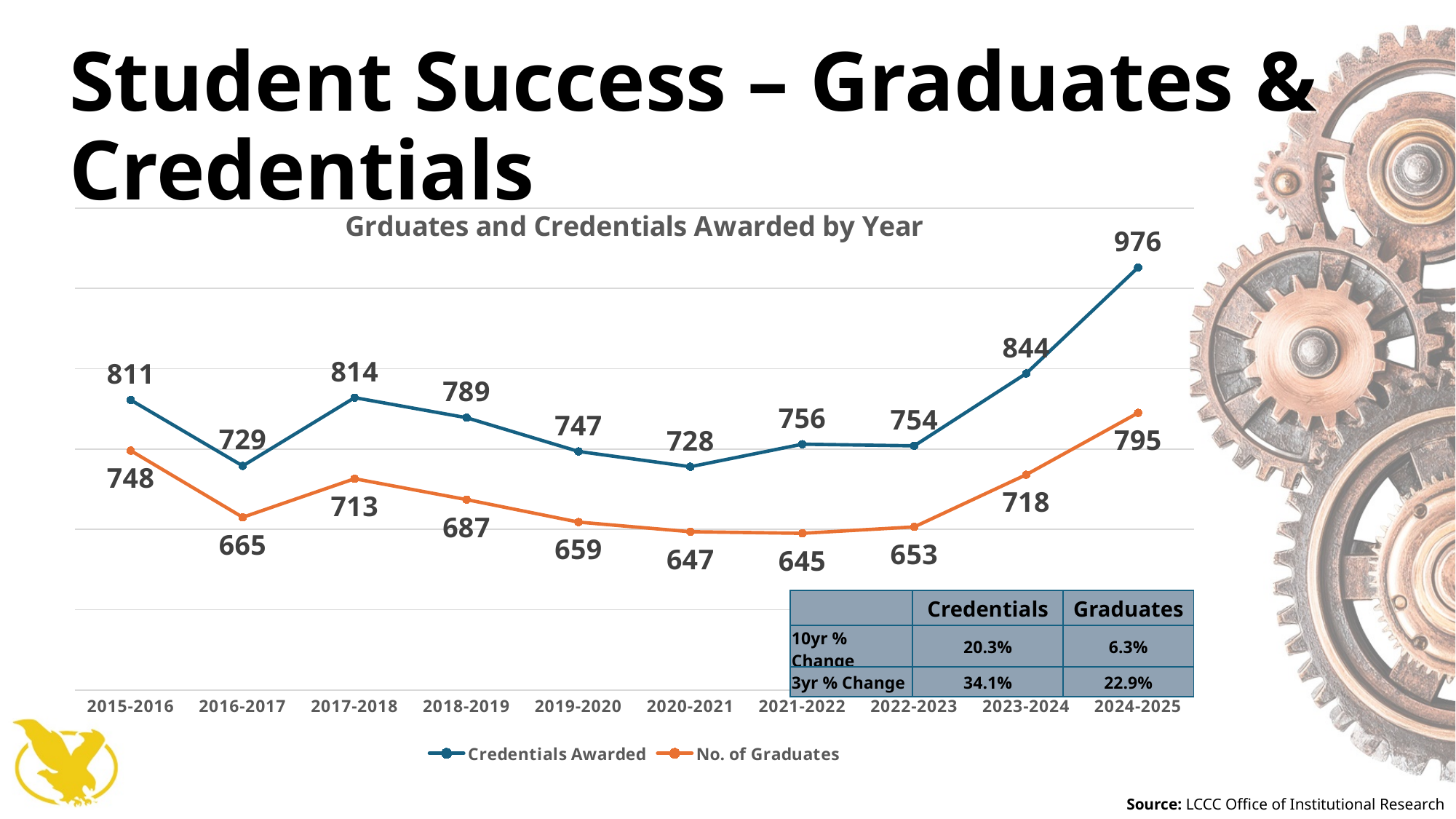
Did the No. of Graduates rise or fall from 2022-2023 to 2024-2025? rise What type of chart is shown on the slide? line chart In which year were Credentials Awarded highest? 2024-2025 What colour is the line for No. of Graduates? orange How many series does the legend list? 2 What is the title of the chart? Grduates and Credentials Awarded by Year What is the difference between Credentials Awarded and No. of Graduates in 2023-2024? 126 In which year was the No. of Graduates lowest? 2021-2022 How many Credentials Awarded were there in 2024-2025? 976 Which was larger in 2016-2017: Credentials Awarded or No. of Graduates? Credentials Awarded What was the No. of Graduates in 2020-2021? 647 How many academic years are plotted on the x axis? 10